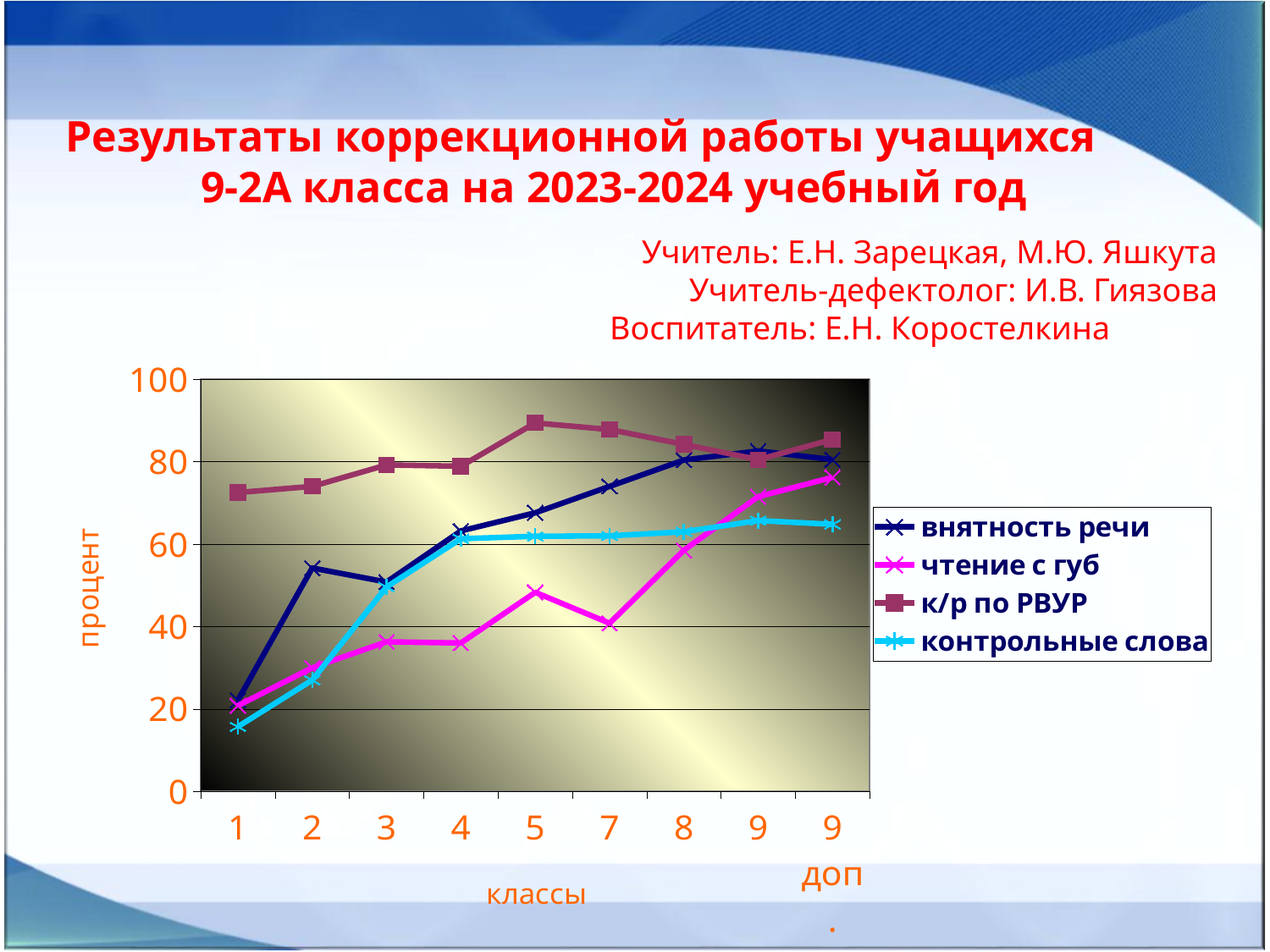
At class 9 доп., which is larger: чтение с губ or контрольные слова? чтение с губ How many series does the legend list? 4 Does the внятность речи series generally rise or fall from class 1 to class 9 доп.? rise What kind of chart is shown on the slide? line chart Which series has the highest value at class 1? к/р по РВУР Which series has the lowest value at class 1? контрольные слова Is the value of к/р по РВУР at class 1 greater or less than 60? greater Is the value of к/р по РВУР at class 5 greater or less than 80? greater What is the label of the horizontal axis? классы Is the value of контрольные слова at class 1 greater or less than 20? less What is the label of the vertical axis? процент How many categories are shown along the x axis? 9